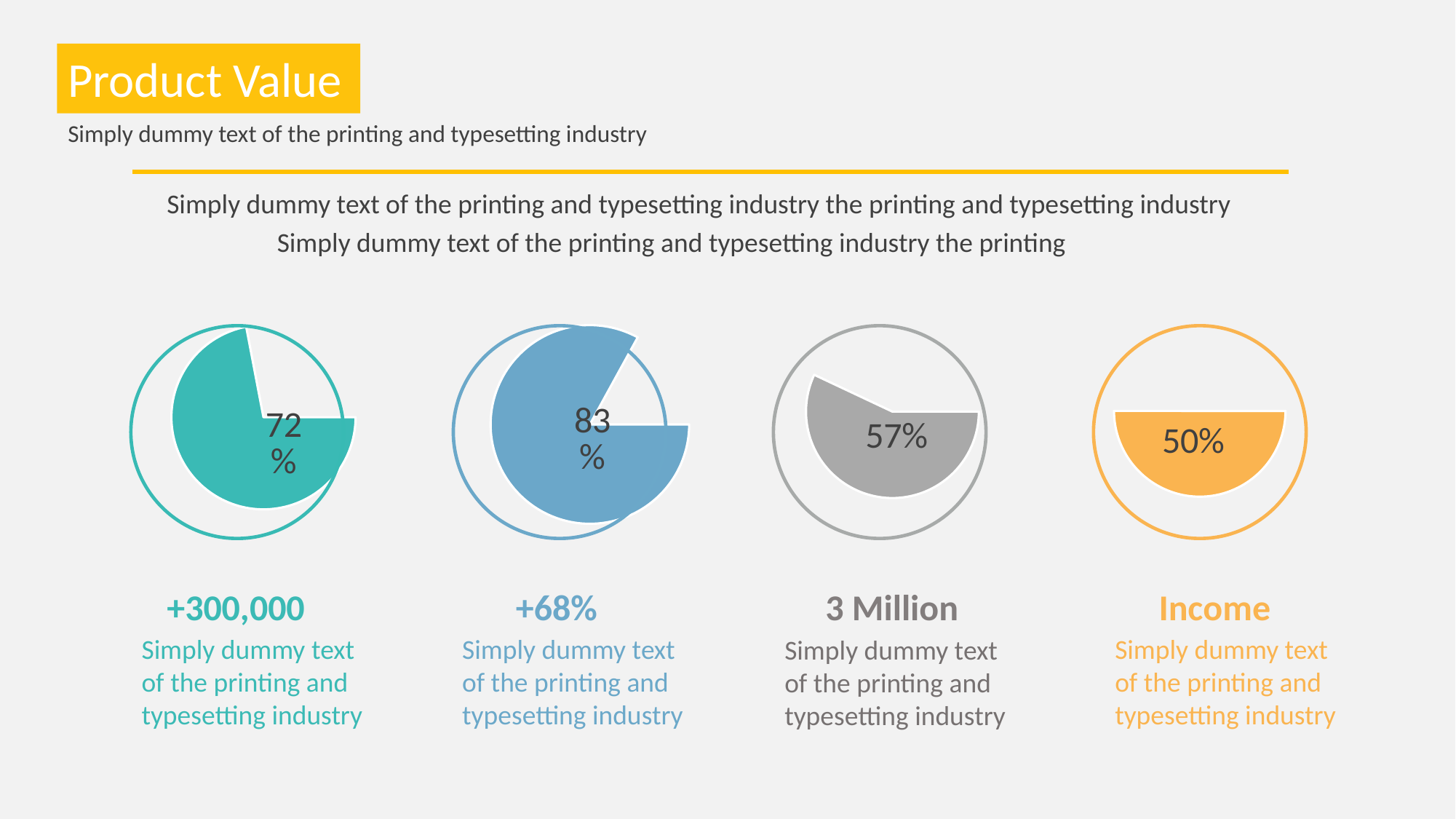
What is the difference between the percentage in the blue pie chart and the percentage in the teal pie chart? 11 percentage points Which of the four pie charts shows the highest percentage? The blue chart (83%) What caption appears directly below the grey pie chart? 3 Million What percentage is shown in the grey pie chart, third from the left? 57% What caption appears directly below the teal pie chart on the far left? +300,000 What percentage is shown in the teal pie chart on the far left of the slide? 72% What kind of chart is used for the four figures on the slide? Pie chart Which shows a larger percentage, the teal pie chart or the grey pie chart? The teal pie chart (72%) How many pie charts are shown on the slide? 4 What percentage is shown in the orange pie chart on the far right, above the 'Income' label? 50% What percentage is shown in the blue pie chart, second from the left? 83% Which of the four pie charts shows the lowest percentage? The orange chart (50%)